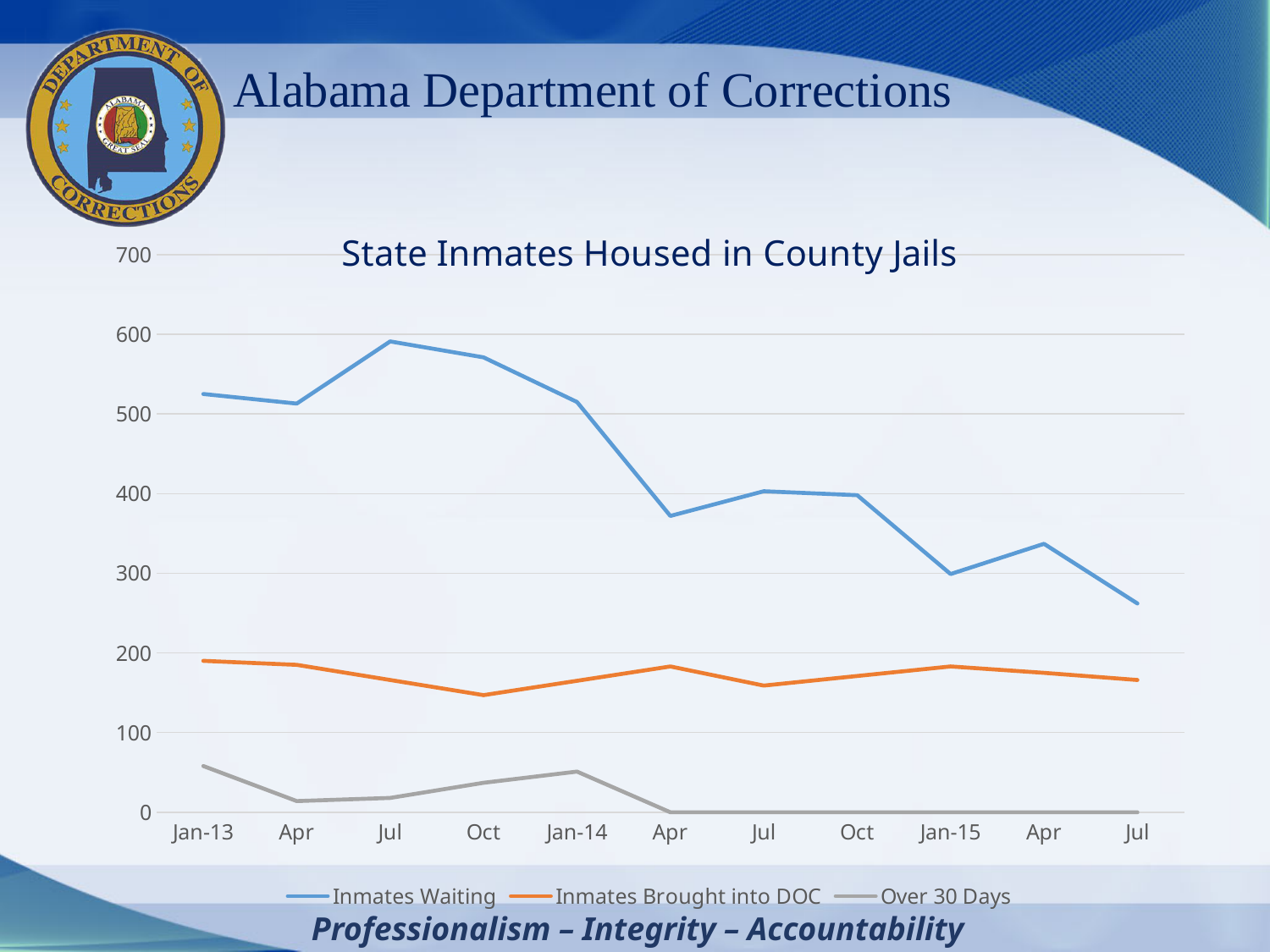
Is the value for Inmates Brought into DOC at Oct-13 greater or less than 100? greater Which series has the highest values throughout the chart? Inmates Waiting Which is larger at Jan-13: Inmates Waiting or Inmates Brought into DOC? Inmates Waiting Is the value for Inmates Waiting at Jul-13 greater or less than 500? greater Does the Inmates Waiting series generally rise or fall from Jan-13 to Jul-15? Fall How many points are plotted along the x axis for each series? 11 What is the title of the chart? State Inmates Housed in County Jails At which x-axis point does the Inmates Waiting series reach its highest value? Jul (2013) Is the value for Inmates Waiting at Jul-15 greater or less than 300? less At which x-axis point does the Inmates Waiting series reach its lowest value? Jul (2015) What kind of chart is shown on the slide? Line chart How many series does the legend list? 3